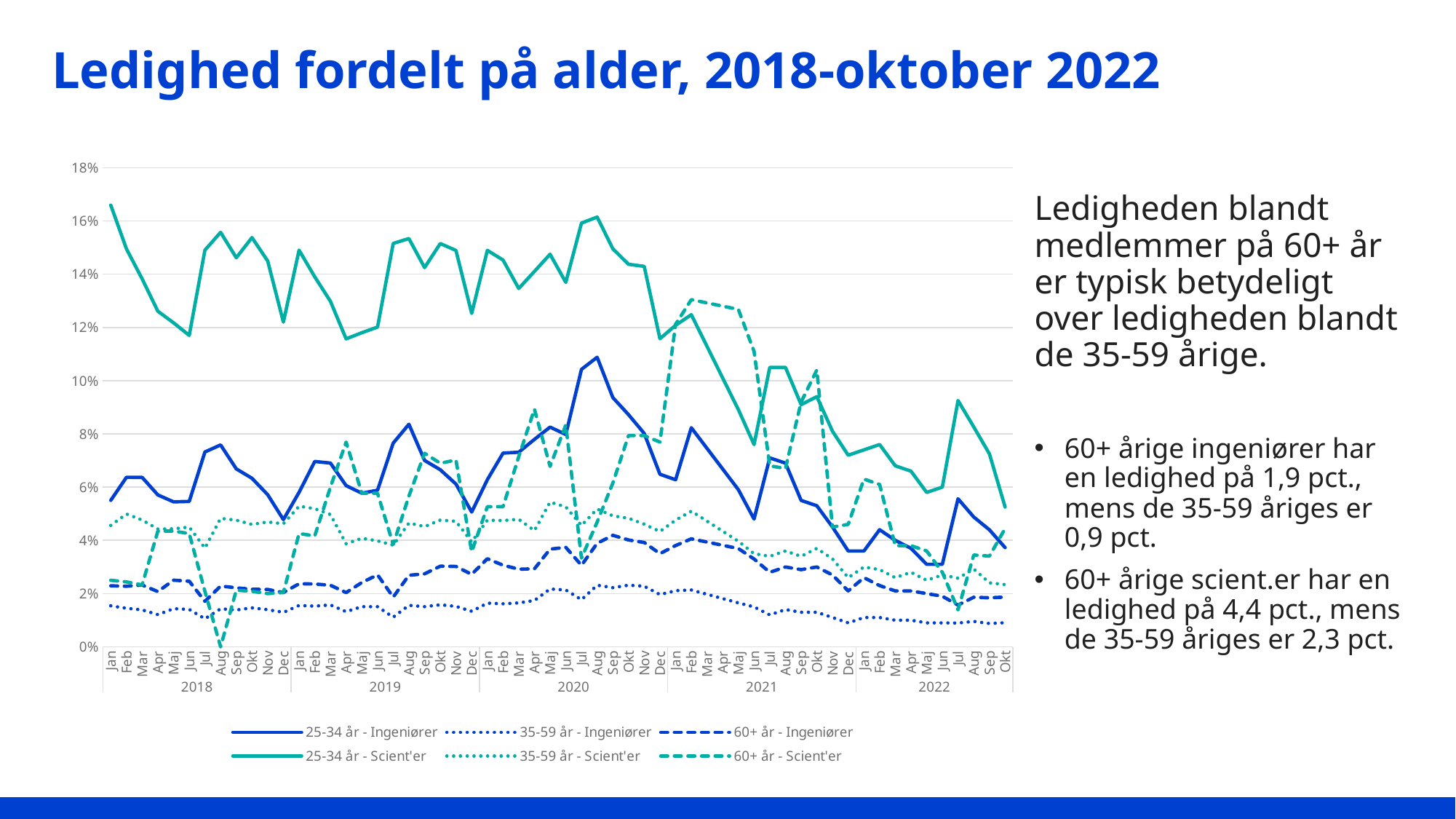
Which series has the highest value in Jan 2018? 25-34 år - Scient'er Is the peak value for 25-34 år - Ingeniører in Aug 2020 greater or less than 10%? greater Is the value for 25-34 år - Scient'er in Oct 2022 greater or less than 6%? less Does the 25-34 år - Scient'er series rise or fall overall from Jan 2018 to Oct 2022? Fall Is the value for 25-34 år - Scient'er in Jan 2018 greater or less than 16%? greater Which series has the lowest value in Jan 2018? 35-59 år - Ingeniører How many years are labelled along the x axis? 5 What is the title of the chart? Ledighed fordelt på alder, 2018-oktober 2022 Which is larger in Jan 2018: 25-34 år - Scient'er or 25-34 år - Ingeniører? 25-34 år - Scient'er How many series does the legend list? 6 What kind of chart is shown on the slide? Line chart